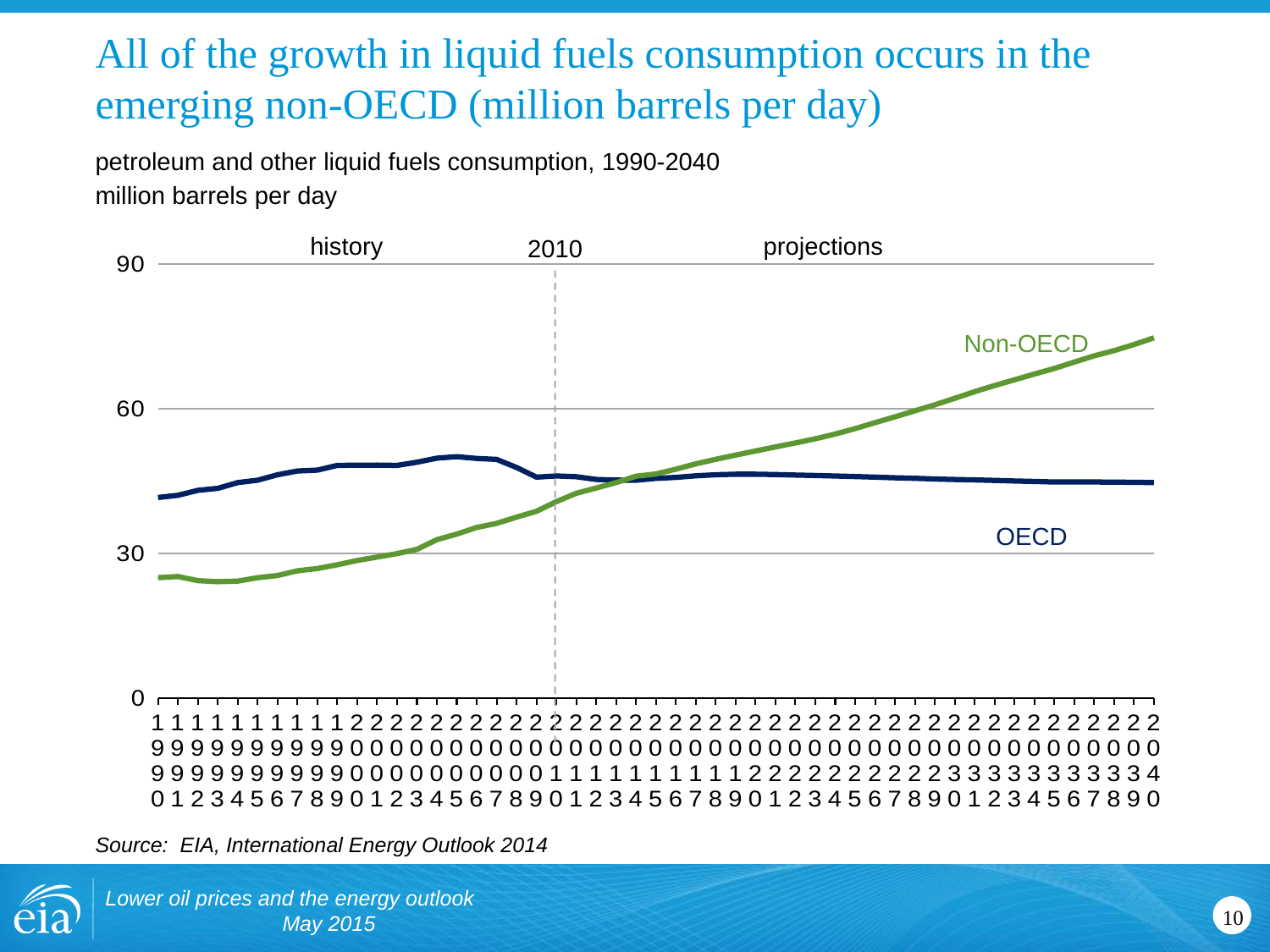
Does the Non-OECD line rise or fall from 2010 to 2040? rise Is the value for OECD in 2040 greater or less than 60? less Is the value for Non-OECD in 1990 greater or less than 30? less What kind of chart is shown on the slide? line chart Is the value for Non-OECD in 2040 greater or less than 60? greater In 1990, which series has the higher consumption, OECD or Non-OECD? OECD Which two series are labelled on the chart? Non-OECD and OECD How many years are shown along the x axis, from 1990 to 2040? 51 How many series are plotted on the chart? 2 In 2040, which series has the higher consumption, OECD or Non-OECD? Non-OECD What year does the vertical dashed line separating history from projections mark? 2010